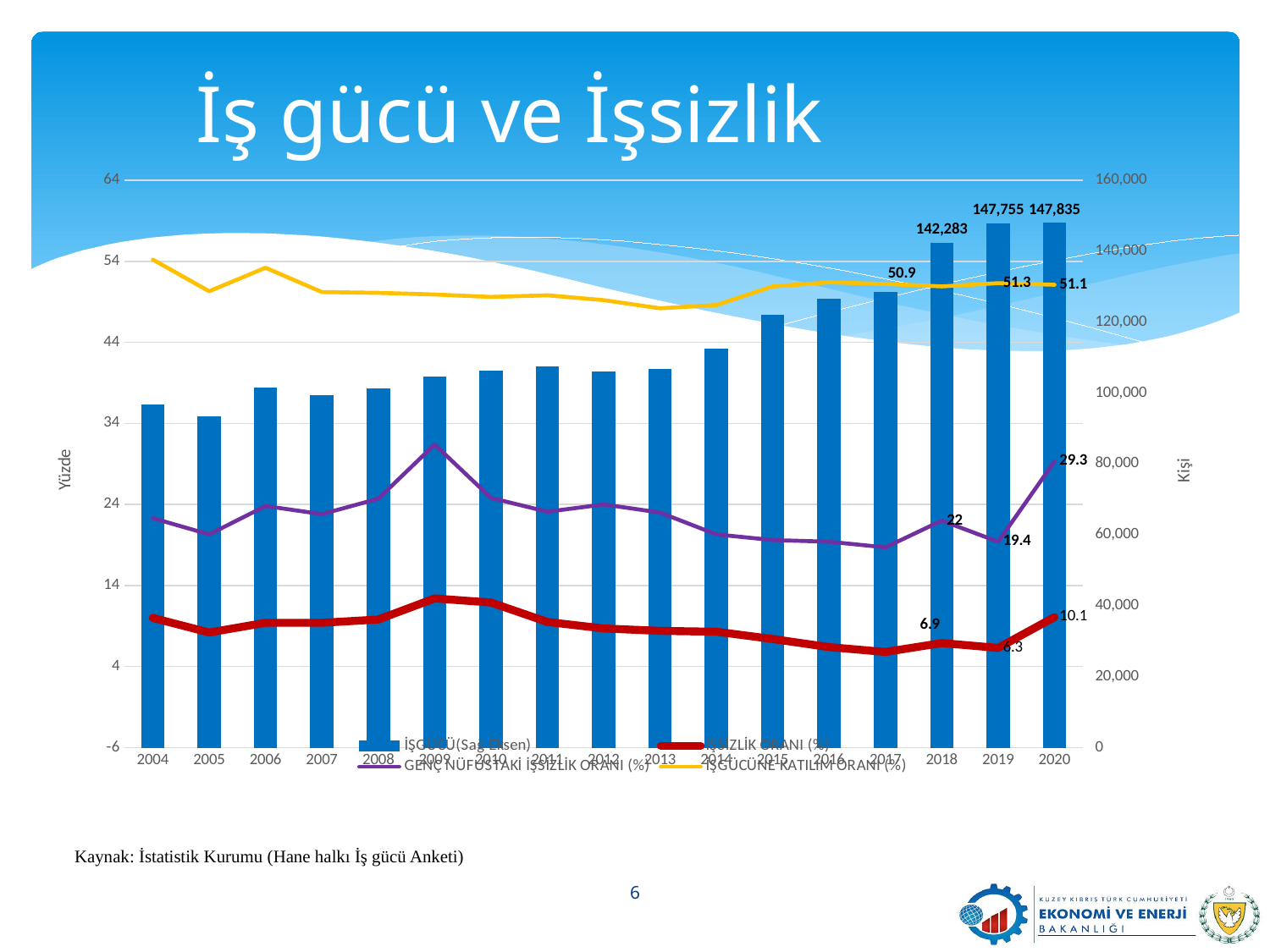
Which year has the higher GENÇ NÜFUSTAKİ İŞSİZLİK ORANI (%), 2018 or 2020? 2020 How many years are shown on the x axis of the chart? 17 What is the İŞGÜCÜNE KATILIM ORANI (%) value for 2019? 51.3 What is the GENÇ NÜFUSTAKİ İŞSİZLİK ORANI (%) value for 2019? 19.4 Which year has the highest İŞGÜCÜ (Sağ Eksen) value? 2020 What is the value of İŞGÜCÜ (Sağ Eksen) for 2018? 142,283 By how much did İŞGÜCÜ (Sağ Eksen) increase from 2019 to 2020? 80 What is the İŞSİZLİK ORANI (%) value for 2020? 10.1 Is the İŞGÜCÜ (Sağ Eksen) value for 2004 greater or less than 120,000? less What is the difference between the İŞSİZLİK ORANI (%) values for 2020 and 2019? 3.8 How many series does the chart legend list? 4 What is the value of İŞGÜCÜ (Sağ Eksen) for 2020? 147,835